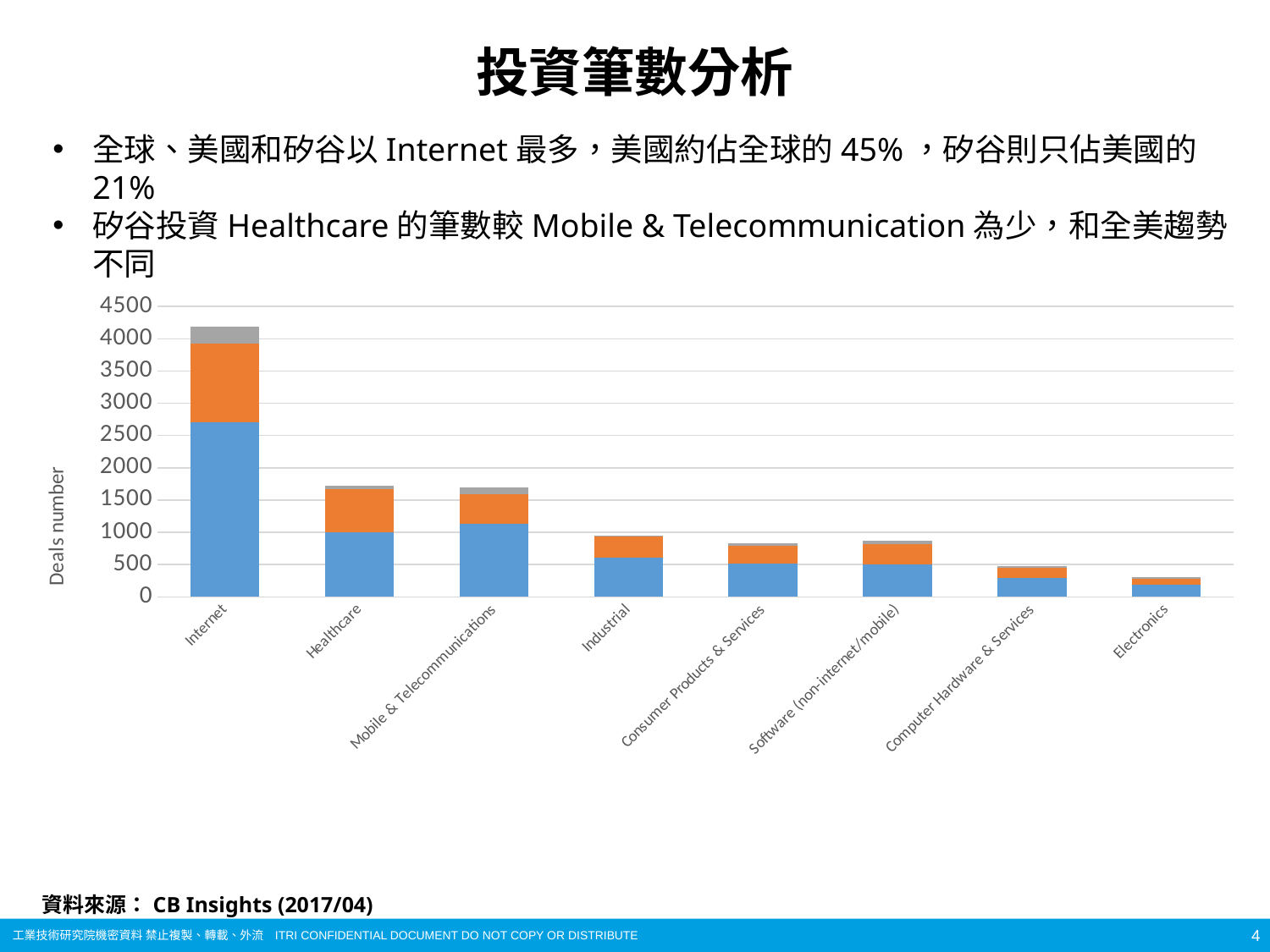
Do the total deals numbers generally rise or fall from left to right across the categories? fall Is the total deals number for Healthcare greater or less than 1500? greater Which category has the lowest total deals number? Electronics What is the label on the vertical axis of the chart? Deals number Which has a larger total deals number, Internet or Healthcare? Internet Which category has the highest total deals number? Internet What kind of chart is shown on the slide? Stacked bar chart Is the total deals number for Internet greater or less than 4000? greater How many categories are shown on the x axis of the chart? 8 Is the total deals number for Electronics greater or less than 500? less